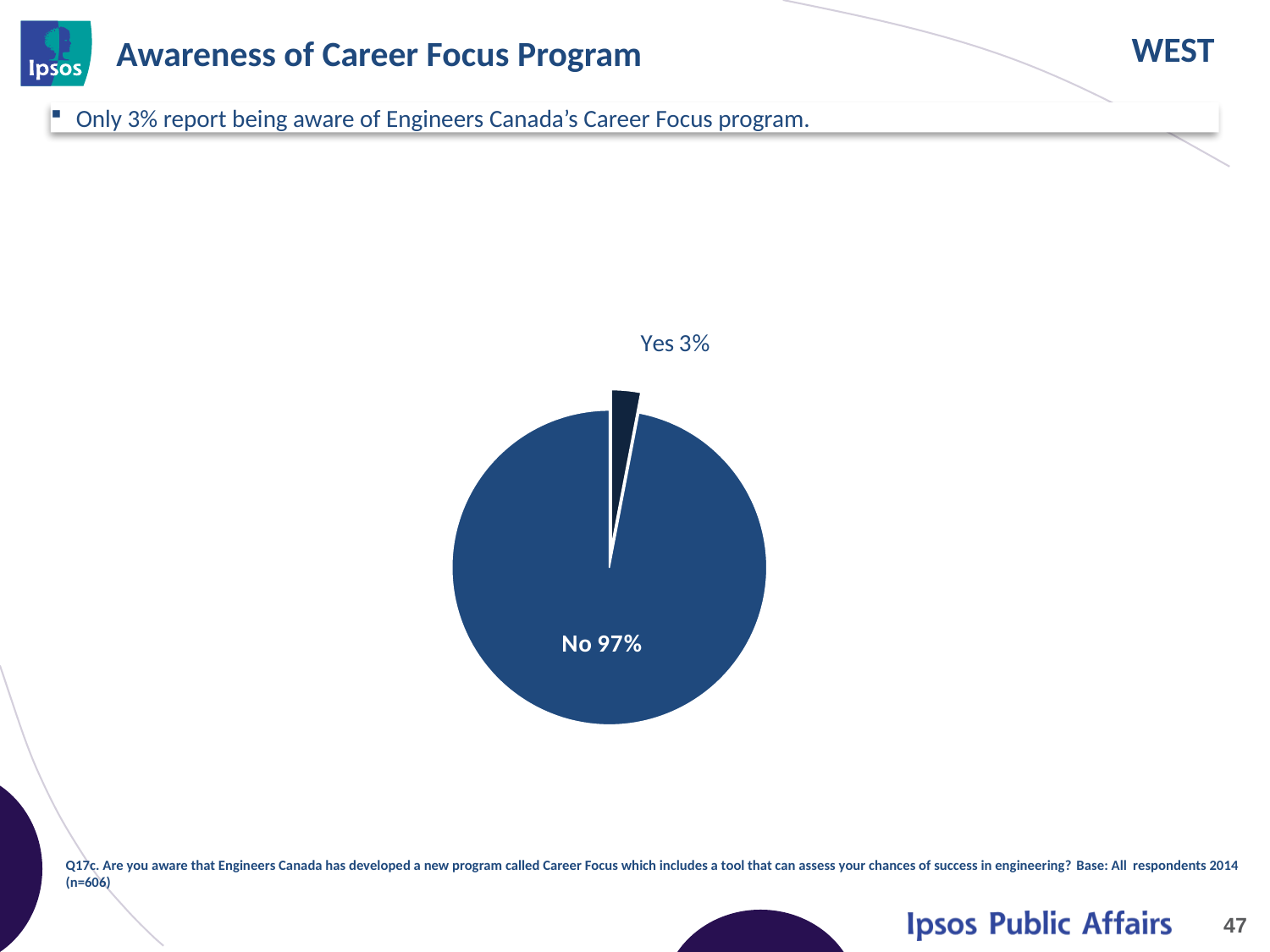
What is the sample size (n) stated in the base note below the chart? 606 What is the difference between the "No" and "Yes" percentages? 94% What is the title of the slide containing the chart? Awareness of Career Focus Program What percentage of respondents answered "Yes"? 3% What kind of chart is shown on the slide? pie chart Which slice of the pie is the largest? No Which is larger, the "Yes" slice or the "No" slice? No Which slice of the pie is the smallest? Yes How many slices does the pie chart have? 2 What share of the pie does the "Yes" slice represent? 3% What percentage of respondents answered "No"? 97%